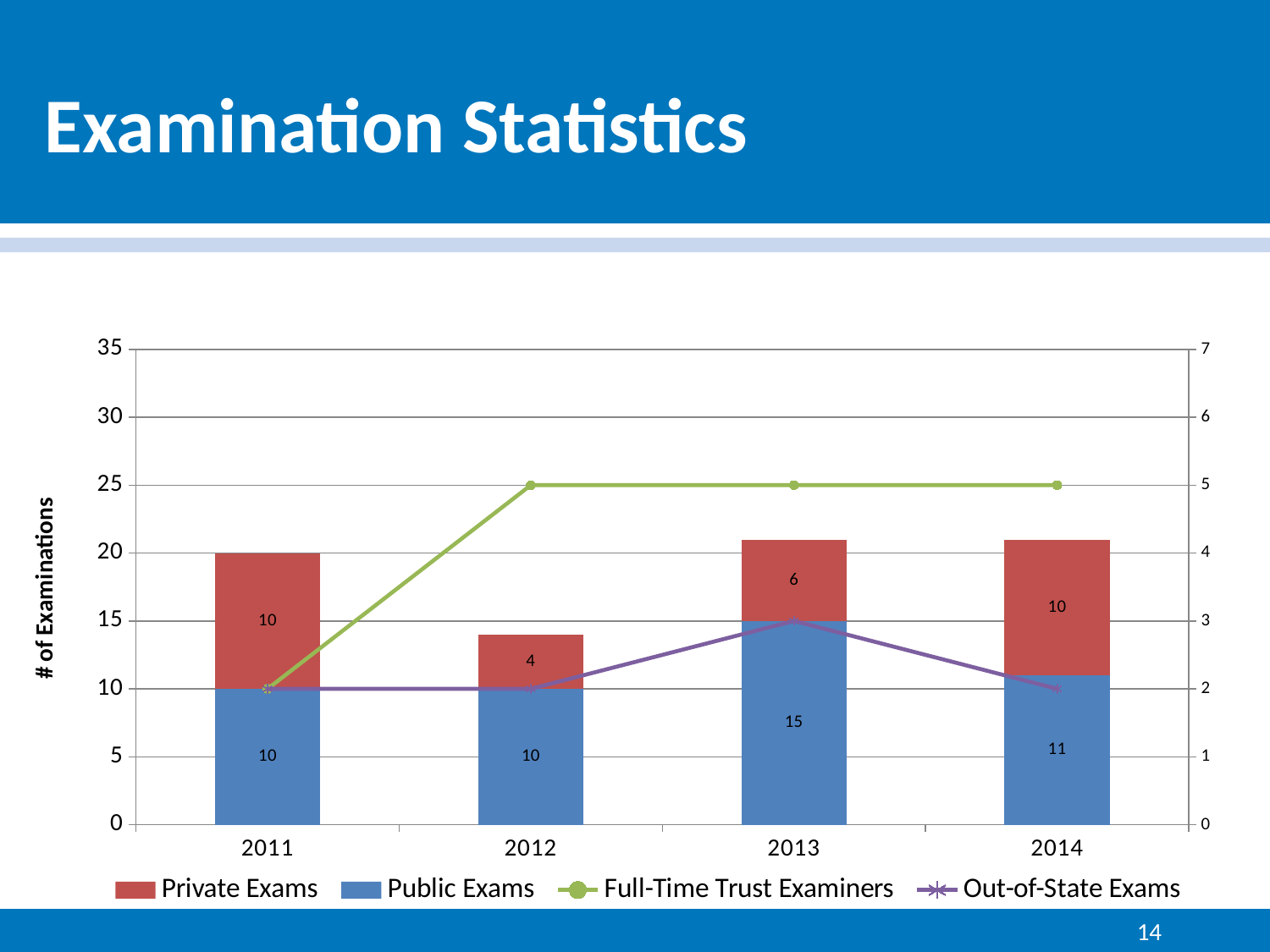
What is the total number of exams (Private plus Public) in 2011? 20 Which is larger, Private Exams in 2011 or Private Exams in 2013? Private Exams in 2011 What is the difference between Public Exams and Private Exams in 2013? 9 Which year had the highest number of Public Exams? 2013 Which year had the lowest number of Private Exams? 2012 What is the total number of exams (Private plus Public) in 2012? 14 How many Public Exams were there in 2014? 11 What is the label of the left vertical axis? # of Examinations How many series does the legend list? 4 How many Public Exams were there in 2013? 15 How many Private Exams were there in 2012? 4 How many years are shown on the x axis? 4